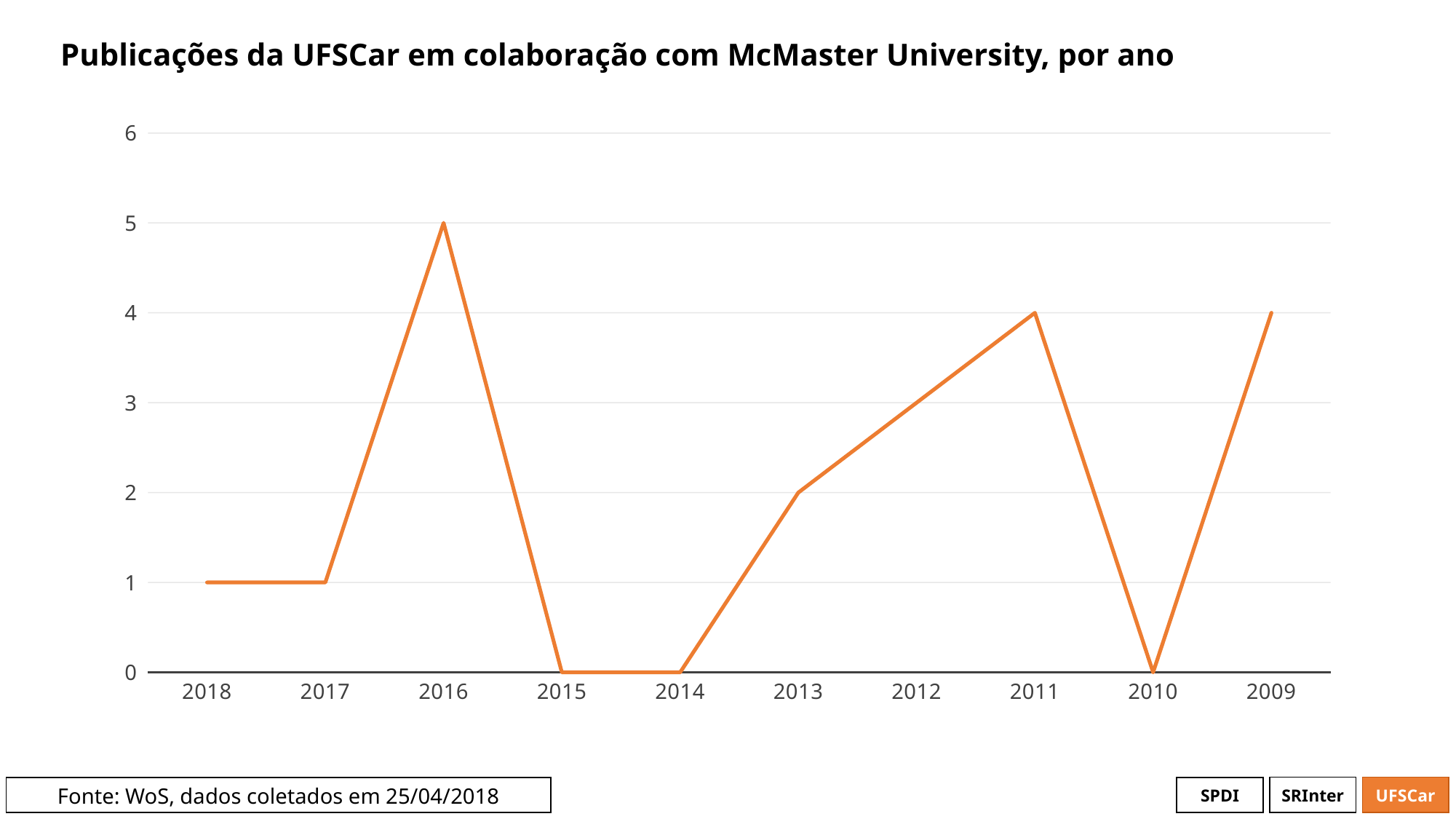
Do the values rise or fall from 2013 to 2011? rise Which year has the highest number of publications? 2016 What is the number of publications in 2018? 1 Is the value for 2016 greater or less than 4? greater What is the number of publications in 2016? 5 What is the difference between the values for 2016 and 2011? 1 What is the number of publications in 2013? 2 What is the title of the chart? Publicações da UFSCar em colaboração com McMaster University, por ano How many years are plotted on the x axis? 10 What is the number of publications in 2009? 4 What type of chart is shown on the slide? line chart Which is larger, the value for 2013 or the value for 2011? 2011